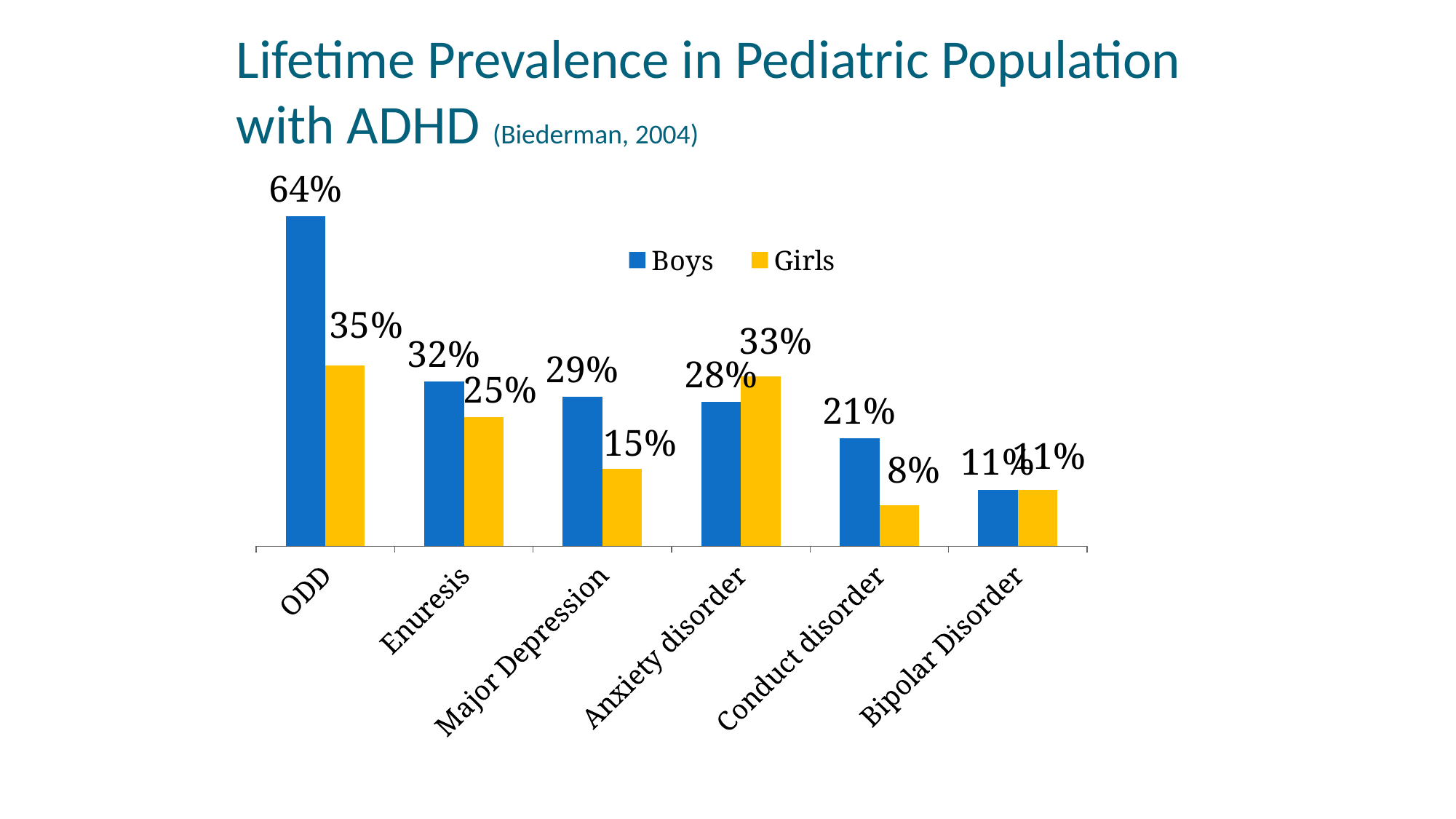
How many series does the legend list? 2 What is the value for Girls for Conduct disorder? 8% Which colour represents Girls in the chart? Yellow What kind of chart is shown on the slide? Bar chart What is the difference between the Boys and Girls values for ODD? 29% What is the value for Girls for Major Depression? 15% Which category has the highest value for Boys? ODD How many categories are shown on the x axis? 6 What is the value for Boys for Anxiety disorder? 28% What is the value for Boys for ODD? 64% Which category has the lowest value for Girls? Conduct disorder Which is larger for Anxiety disorder, the Boys value or the Girls value? Girls